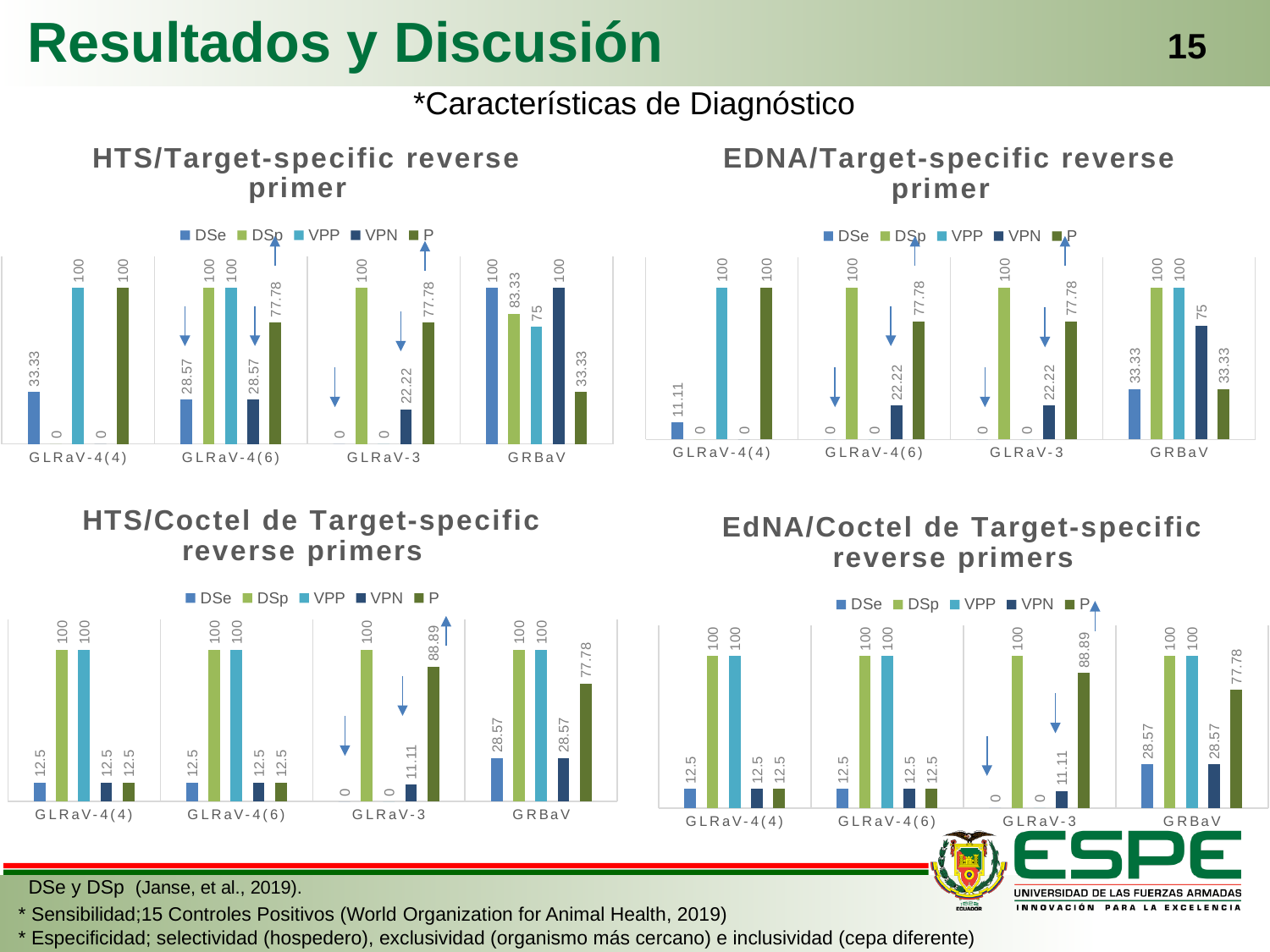
In the 'HTS/Coctel de Target-specific reverse primers' chart, which category has the lowest VPN value? GLRaV-3 In the 'EDNA/Target-specific reverse primer' chart, which is larger for GLRaV-4(6): the VPN value or the P value? P In the 'HTS/Target-specific reverse primer' chart, what is the DSp value for GRBaV? 83.33 In the 'HTS/Target-specific reverse primer' chart, what is the DSe value for GLRaV-4(4)? 33.33 What kind of chart is the 'EDNA/Target-specific reverse primer' chart? Bar chart In the 'HTS/Target-specific reverse primer' chart, what is the difference between the P value for GLRaV-4(6) and the P value for GRBaV? 44.45 In the 'HTS/Coctel de Target-specific reverse primers' chart, what is the P value for GLRaV-3? 88.89 In the 'EDNA/Target-specific reverse primer' chart, what is the VPN value for GRBaV? 75 In the 'EDNA/Target-specific reverse primer' chart, what is the DSe value for GLRaV-4(4)? 11.11 How many series does the legend list in the 'EdNA/Coctel de Target-specific reverse primers' chart? 5 How many categories are shown on the x axis of the 'HTS/Target-specific reverse primer' chart? 4 In the 'EdNA/Coctel de Target-specific reverse primers' chart, what is the DSe value for GRBaV? 28.57